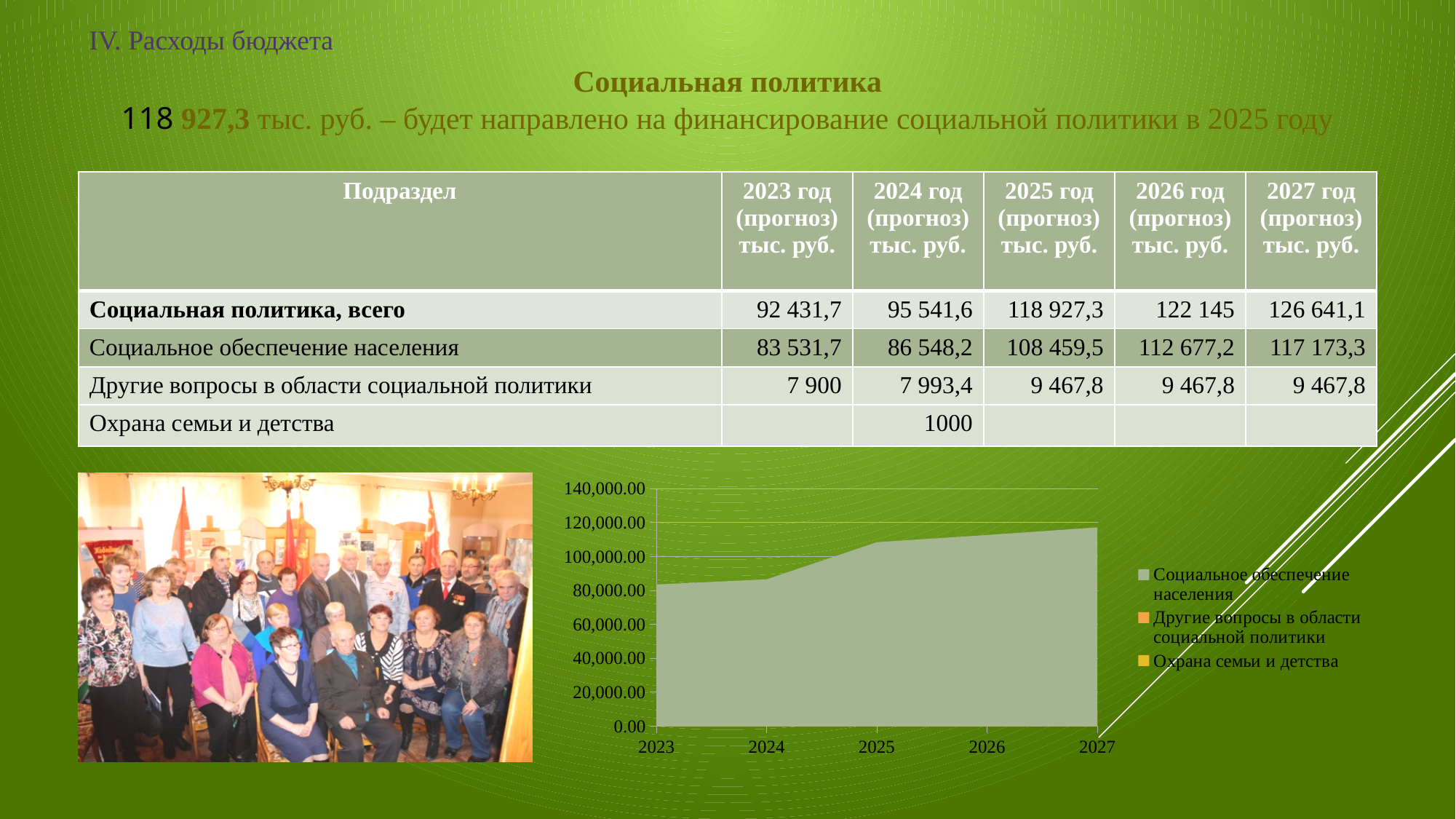
In the chart, is the value for Социальное обеспечение населения in 2025 greater or less than 100,000.00? greater How many series does the chart legend list? 3 Do the values for Социальное обеспечение населения rise or fall from 2023 to 2027 in the chart? rise In the chart, which year has the highest value for Социальное обеспечение населения? 2027 In the chart, which year has the lowest value for Социальное обеспечение населения? 2023 What is the first year shown on the x axis of the chart? 2023 In the chart, is the value for Социальное обеспечение населения in 2023 greater or less than 80,000.00? greater How many years are shown along the x axis of the chart? 5 What kind of chart is shown on the slide? area chart In the chart, is the value for Социальное обеспечение населения in 2026 greater or less than 100,000.00? greater